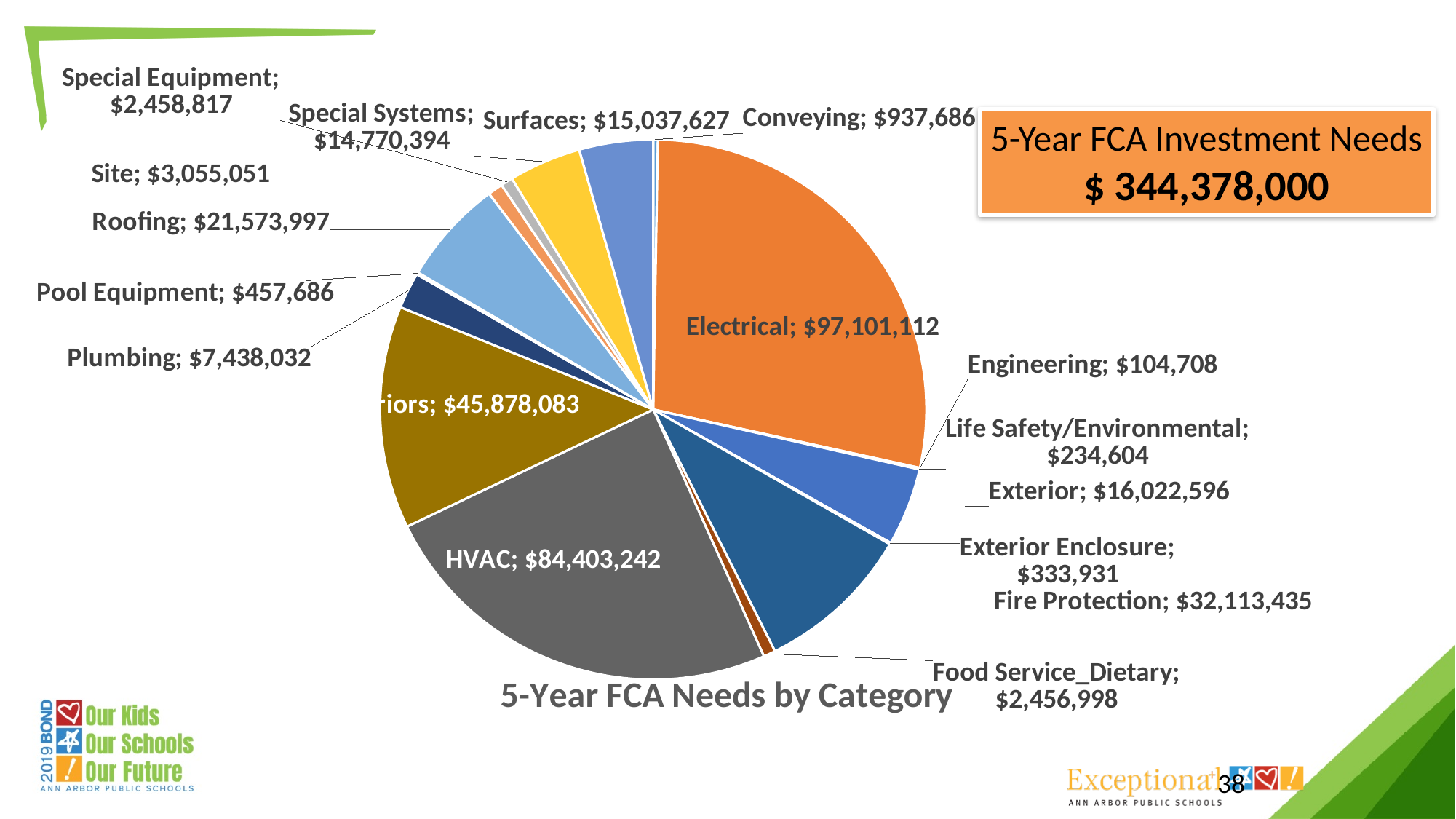
What is the difference between the Electrical and HVAC values in the pie chart? $12,697,870 What is the value shown for HVAC in the pie chart? $84,403,242 What kind of chart is shown on the slide? Pie chart What is the difference between the Roofing and Exterior values in the pie chart? $5,551,401 What is the title of the pie chart? 5-Year FCA Needs by Category Which is larger in the pie chart, Fire Protection or Roofing? Fire Protection Which category has the smallest value in the pie chart? Engineering Which category has the largest slice in the pie chart? Electrical What is the value shown for Fire Protection in the pie chart? $32,113,435 What is the value shown for Electrical in the pie chart? $97,101,112 What total 5-Year FCA Investment Needs figure is shown in the box next to the pie chart? $ 344,378,000 What is the value shown for Roofing in the pie chart? $21,573,997